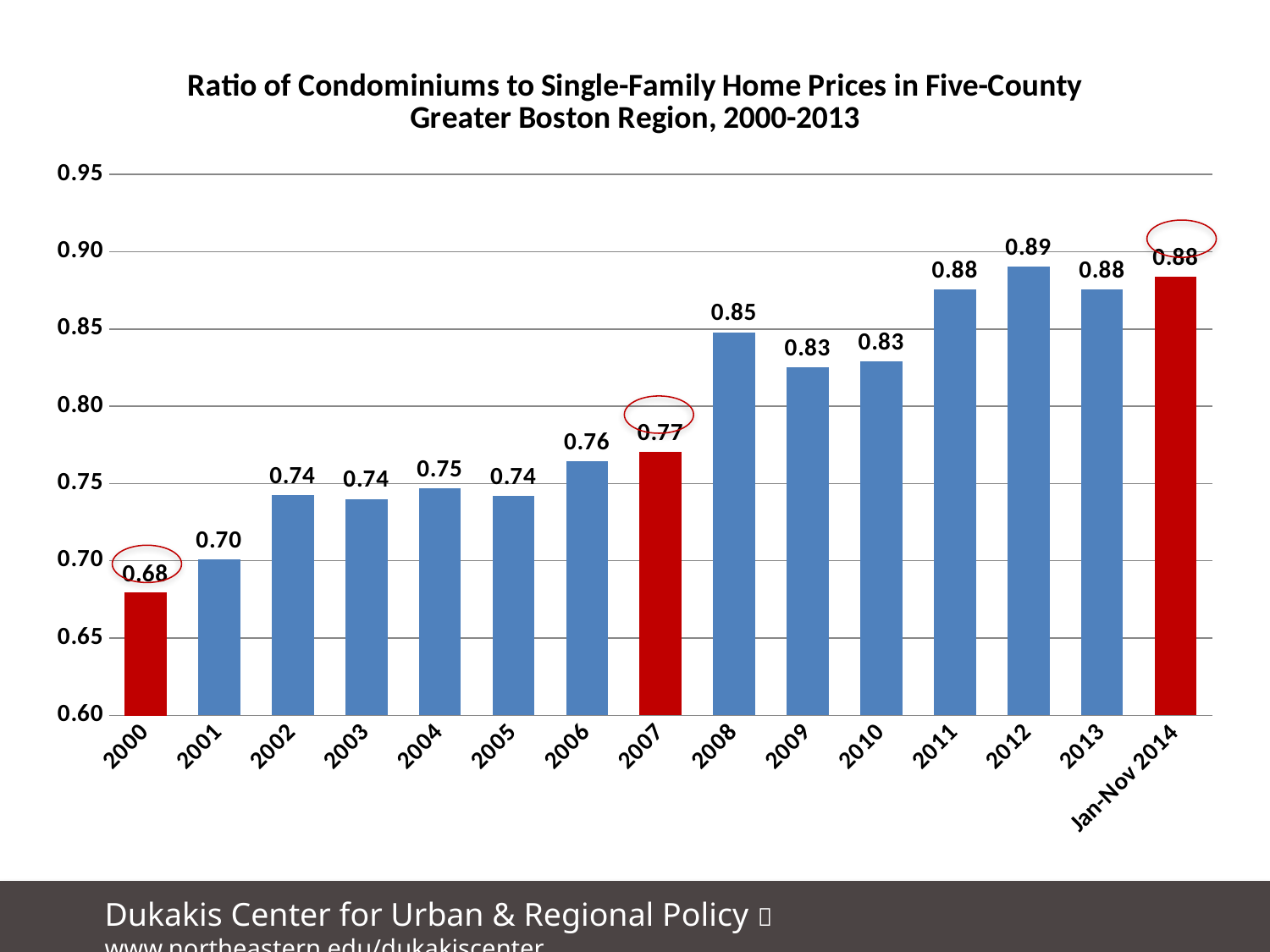
How many bars are plotted in the chart? 15 What is the ratio of condominium to single-family home prices in 2000? 0.68 Which bars are coloured red rather than blue? 2000, 2007 and Jan-Nov 2014 What is the ratio value shown for 2007? 0.77 What kind of chart is shown on the slide? Bar chart Is the value for 2006 greater or less than 0.80? less What is the ratio value shown for Jan-Nov 2014? 0.88 Which year has the lowest ratio of condominium to single-family home prices? 2000 What is the difference between the ratio in 2012 and the ratio in 2000? 0.21 Which is larger, the ratio in 2008 or the ratio in 2009? 2008 Which year has the highest ratio of condominium to single-family home prices? 2012 Overall, do the ratio values rise or fall from 2000 to 2013? Rise